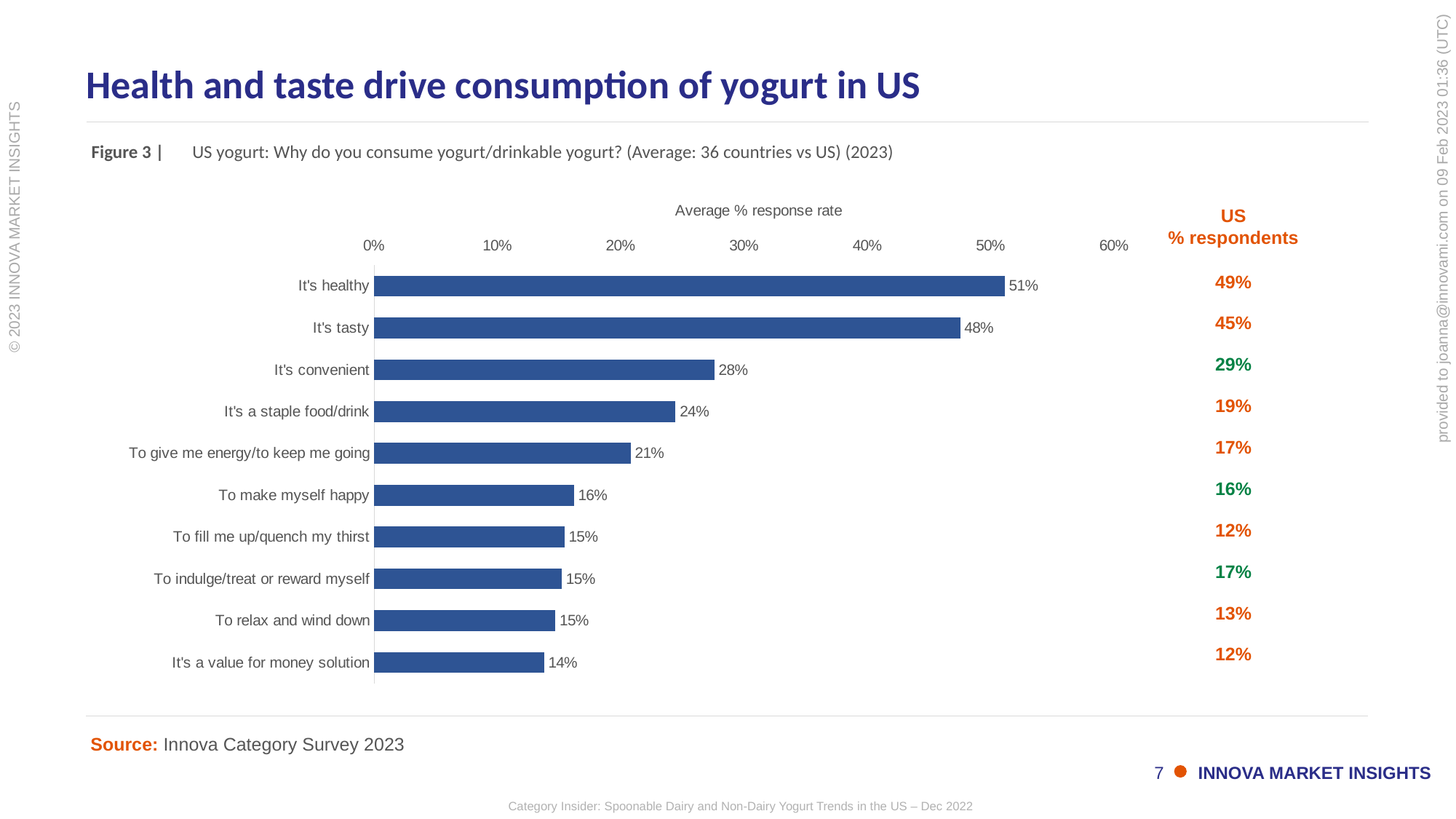
How many reasons for consuming yogurt are listed in the chart? 10 What is the US % respondents value for "It's tasty"? 45% What is the source cited for the chart? Innova Category Survey 2023 Which reason has the highest average % response rate? It's healthy What is the US % respondents value for "To indulge/treat or reward myself"? 17% What is the average % response rate for "It's convenient"? 28% What is the difference between the average % response rate and the US % respondents value for "It's a staple food/drink"? 5% What type of chart is shown on the slide? Bar chart What is the average % response rate for "It's healthy"? 51% What is the difference between the average % response rate for "It's healthy" and "It's tasty"? 3% Which is larger for "To make myself happy": the average % response rate or the US % respondents value? Neither; both are 16% Which reason has the lowest average % response rate? It's a value for money solution